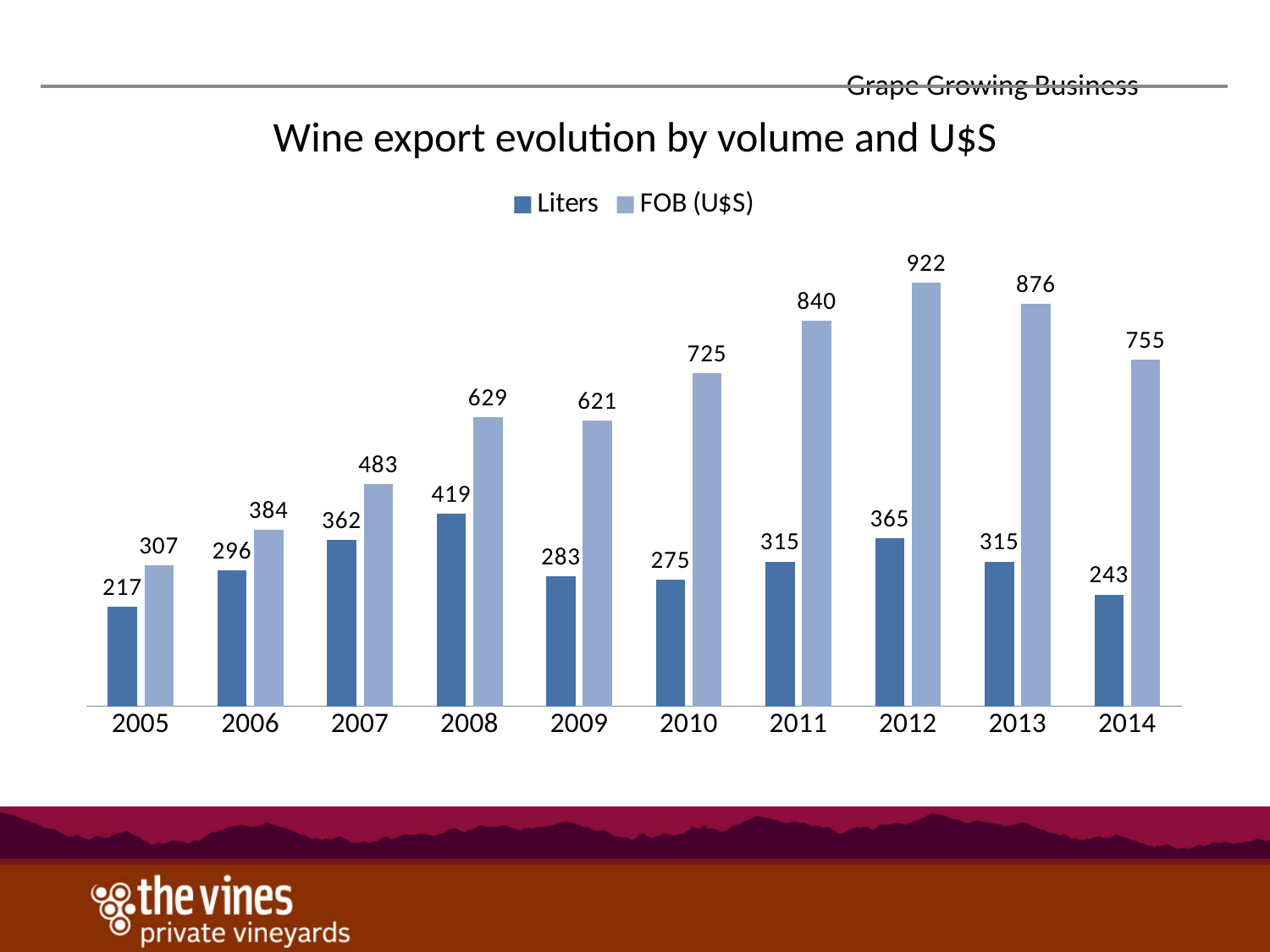
What is the Liters value for 2008? 419 What is the title of the chart? Wine export evolution by volume and U$S How many years are shown on the x axis? 10 Which is larger, the Liters value for 2007 or the Liters value for 2009? 2007 What is the FOB (U$S) value for 2005? 307 Which year has the highest FOB (U$S) value? 2012 What is the difference between the FOB (U$S) values for 2013 and 2014? 121 What kind of chart is shown on the slide? Bar chart Which year has the lowest Liters value? 2005 How many series does the legend list? 2 Does the FOB (U$S) value rise or fall from 2009 to 2012? Rise What is the FOB (U$S) value for 2012? 922